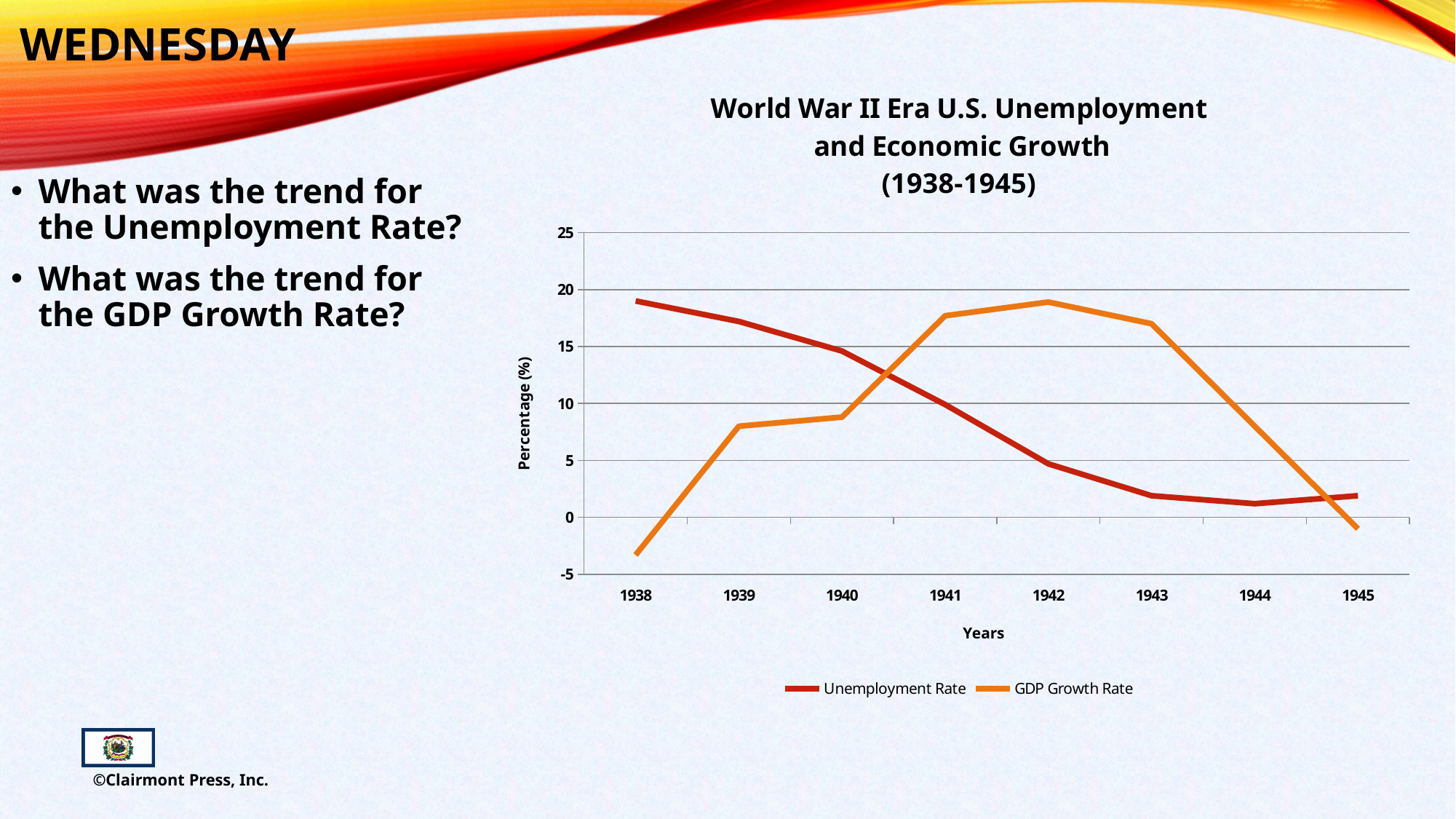
How many series does the chart's legend list? 2 In which year is the GDP Growth Rate lowest? 1938 In which year does the GDP Growth Rate reach its highest value? 1942 Does the Unemployment Rate rise or fall overall from 1938 to 1945? Fall In which year is the Unemployment Rate lowest? 1944 In which year is the Unemployment Rate highest? 1938 Is the Unemployment Rate in 1938 greater or less than 15? greater What is the label on the chart's vertical axis? Percentage (%) In 1942, which is larger: the Unemployment Rate or the GDP Growth Rate? GDP Growth Rate Is the GDP Growth Rate in 1938 greater or less than 0? less How many years are plotted along the x axis of the chart? 8 What kind of chart is shown on the slide? Line chart